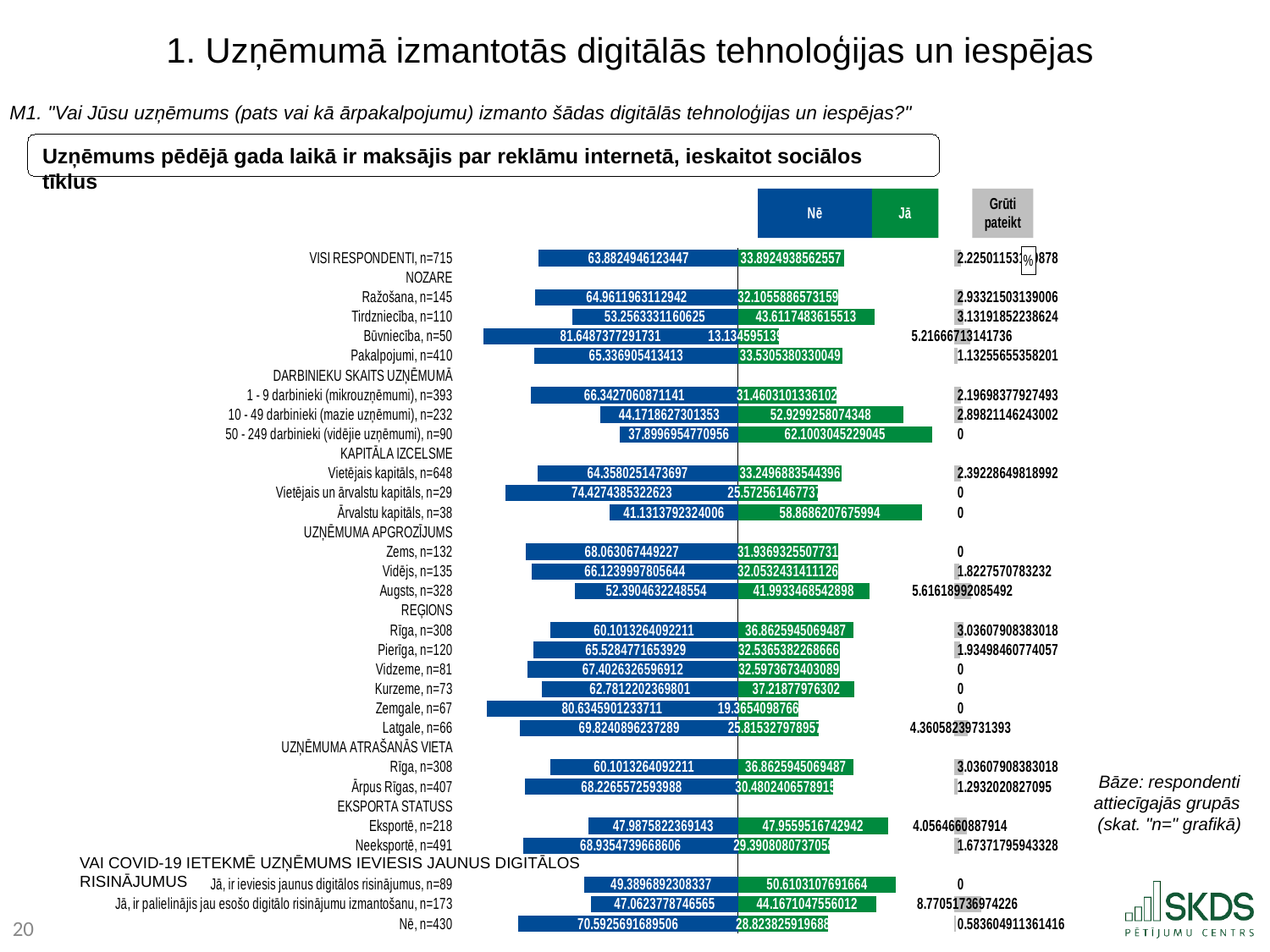
What are the three legend entries of the chart? Nē, Jā, Grūti pateikt What is the Nē value for Ražošana, n=145? 64.9611963112942 What is the difference between the Nē and Jā values for Ražošana, n=145? 32.8556076539783 How many series does the legend list? 3 For Ražošana, n=145, which is larger: the Nē value or the Jā value? Nē What kind of chart is shown on the slide? bar chart Which colour represents the Jā series in the chart? green What is the Nē value for Zemgale, n=67? 80.6345901233711 What is the Grūti pateikt value for Eksportē, n=218? 4.0564660887914 Which category has the highest Nē value? Būvniecība, n=50 Which category has the highest Jā value? 50 - 249 darbinieki (vidējie uzņēmumi), n=90 What is the Jā value for 50 - 249 darbinieki (vidējie uzņēmumi), n=90? 62.1003045229045